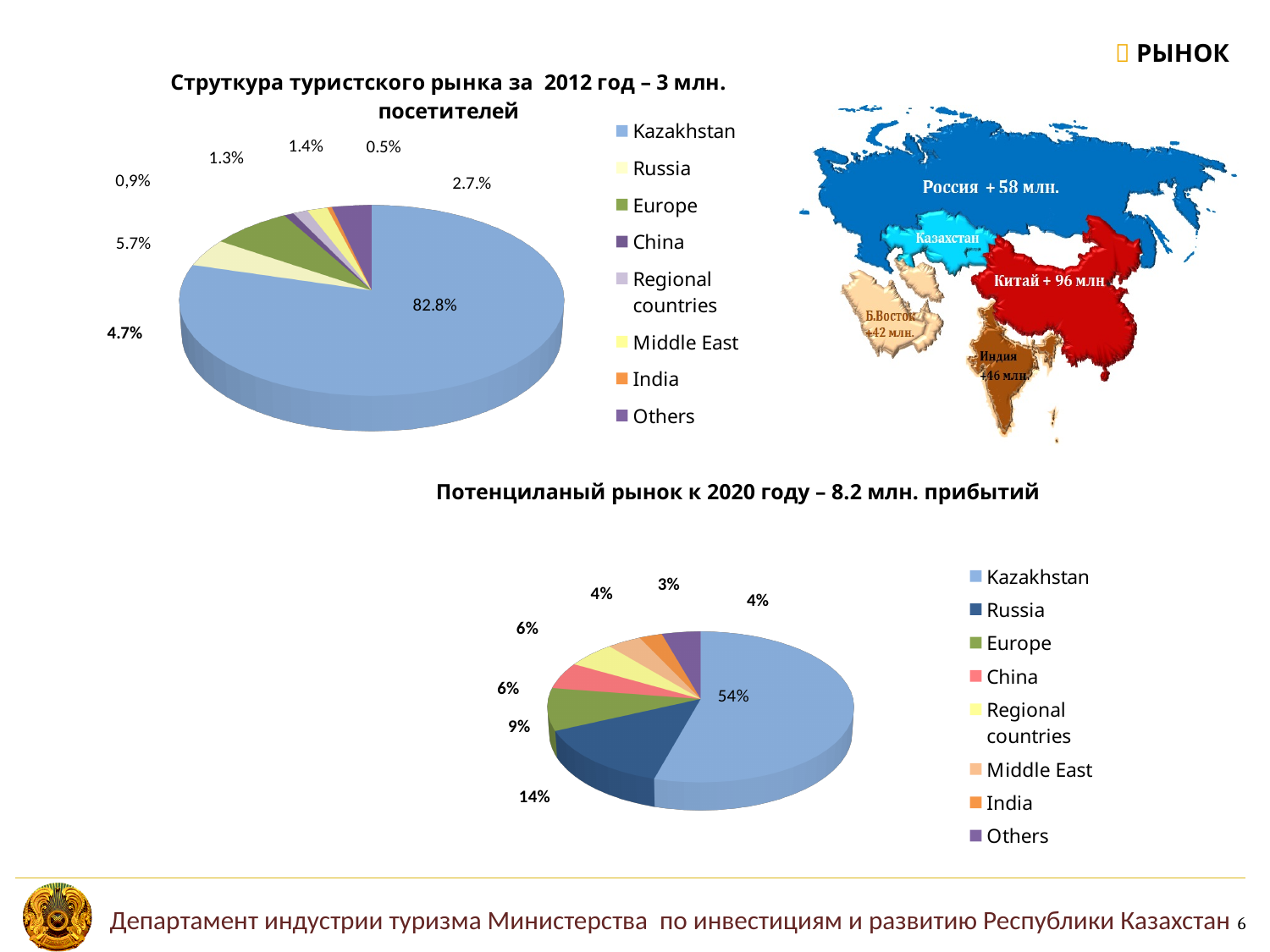
In the bottom chart (potential market by 2020), what share does Kazakhstan have? 54% In the bottom chart (potential market by 2020), what share does China have? 6% How many entries does the legend of the top chart (2012 tourist market structure) list? 8 In the top chart (2012 tourist market structure), which category has the largest share? Kazakhstan In the top chart (2012 tourist market structure), what share does Kazakhstan have? 82.8% In the bottom chart (potential market by 2020), which is larger, the share of Russia or the share of Europe? Russia In the bottom chart (potential market by 2020), which category has the largest share? Kazakhstan In the bottom chart (potential market by 2020), what share does Russia have? 14% What type of chart is used for the 2012 tourist market structure (top chart)? pie chart In the bottom chart (potential market by 2020), what is the difference between the shares of Russia and Europe? 5% In the bottom chart (potential market by 2020), what share does Europe have? 9% How many entries does the legend of the bottom chart (potential market by 2020) list? 8